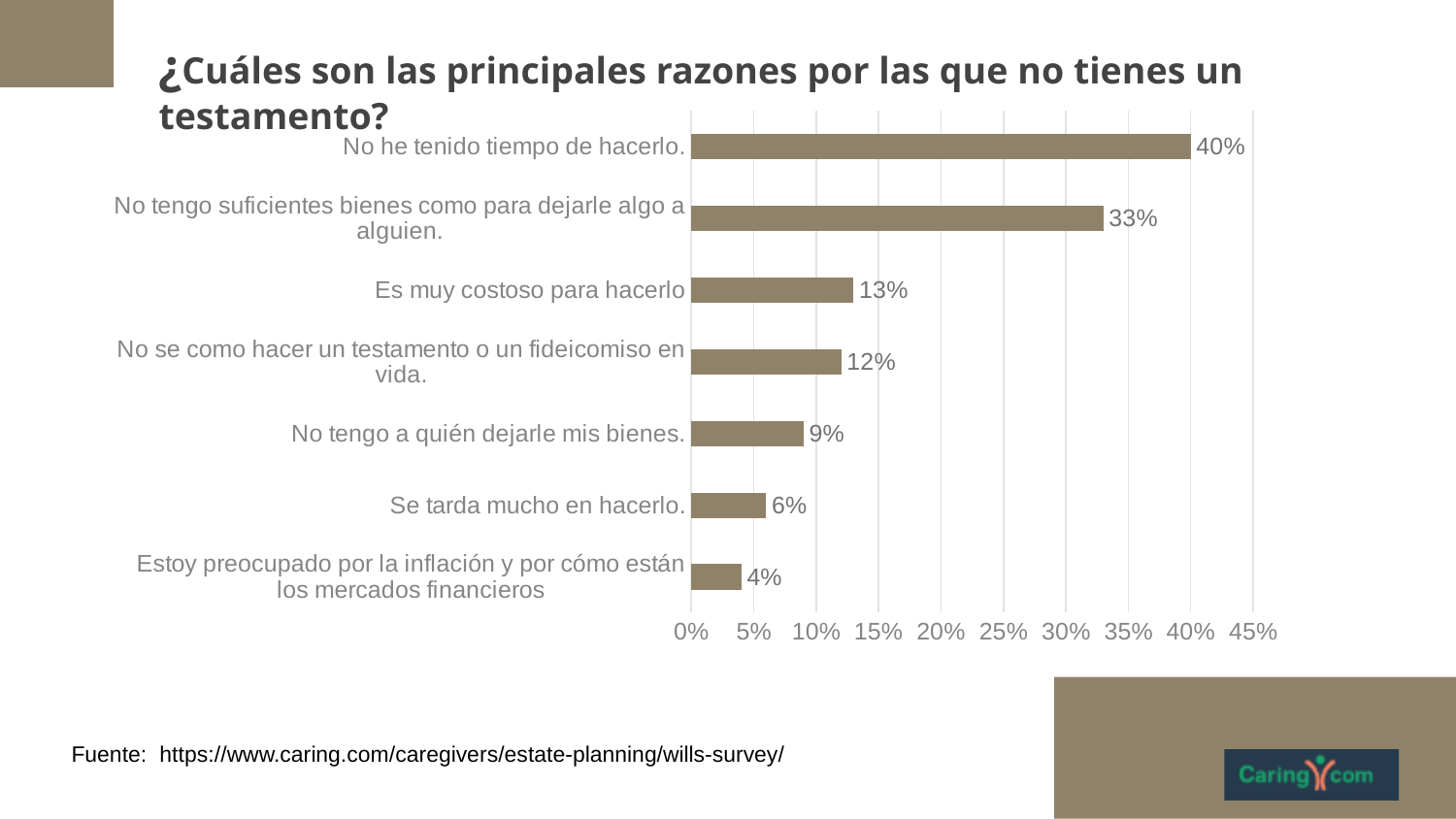
What is the title of the chart? ¿Cuáles son las principales razones por las que no tienes un testamento? Which category has the highest value? No he tenido tiempo de hacerlo. How many categories are shown in the chart? 7 What is the value for "No se como hacer un testamento o un fideicomiso en vida."? 12% What is the value for "Es muy costoso para hacerlo"? 13% What is the difference between the values for "No he tenido tiempo de hacerlo." and "No tengo suficientes bienes como para dejarle algo a alguien."? 7% Is the value for "No tengo suficientes bienes como para dejarle algo a alguien." greater or less than 30%? greater What is the value for "No he tenido tiempo de hacerlo."? 40% What kind of chart is shown on the slide? bar chart Which category has the lowest value? Estoy preocupado por la inflación y por cómo están los mercados financieros What is the value for "Estoy preocupado por la inflación y por cómo están los mercados financieros"? 4% Which is larger: the value for "No tengo a quién dejarle mis bienes." or the value for "Se tarda mucho en hacerlo."? No tengo a quién dejarle mis bienes.